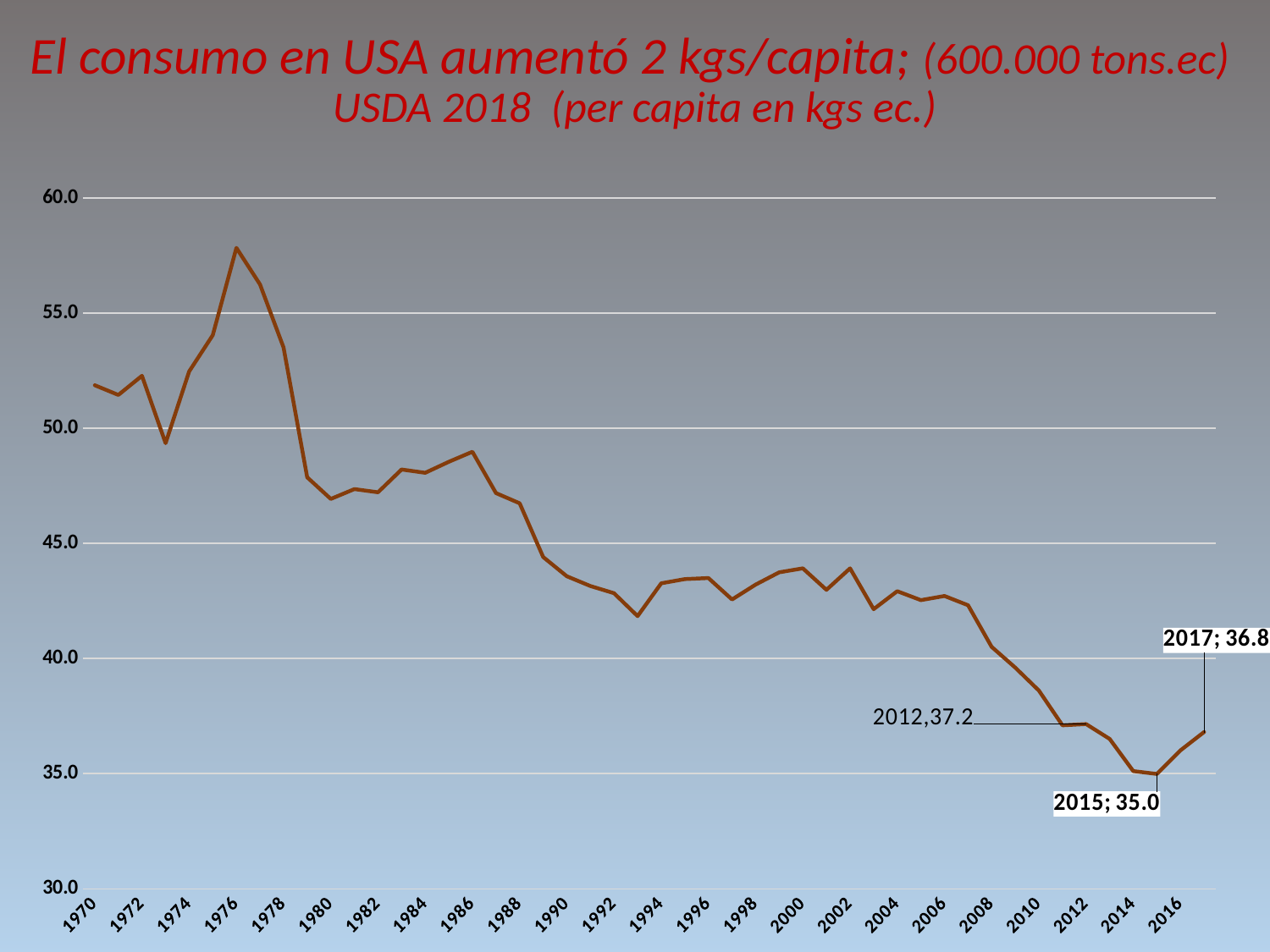
Is the value for 1990 greater or less than 45.0? less Overall, does the line rise or fall from 1970 to 2017? fall What is the per capita consumption value labelled for 2015? 35.0 What is the difference between the labelled values for 2012 and 2015? 2.2 In which year does the line reach its highest point? 1976 In which year does the line reach its lowest point? 2015 What is the difference between the labelled values for 2017 and 2015? 1.8 Which year has the larger labelled value, 2012 or 2017? 2012 Is the value for 1976 greater or less than 55.0? greater What kind of chart is shown on the slide? line chart What is the per capita consumption value labelled for 2012? 37.2 What is the per capita consumption value labelled for 2017? 36.8